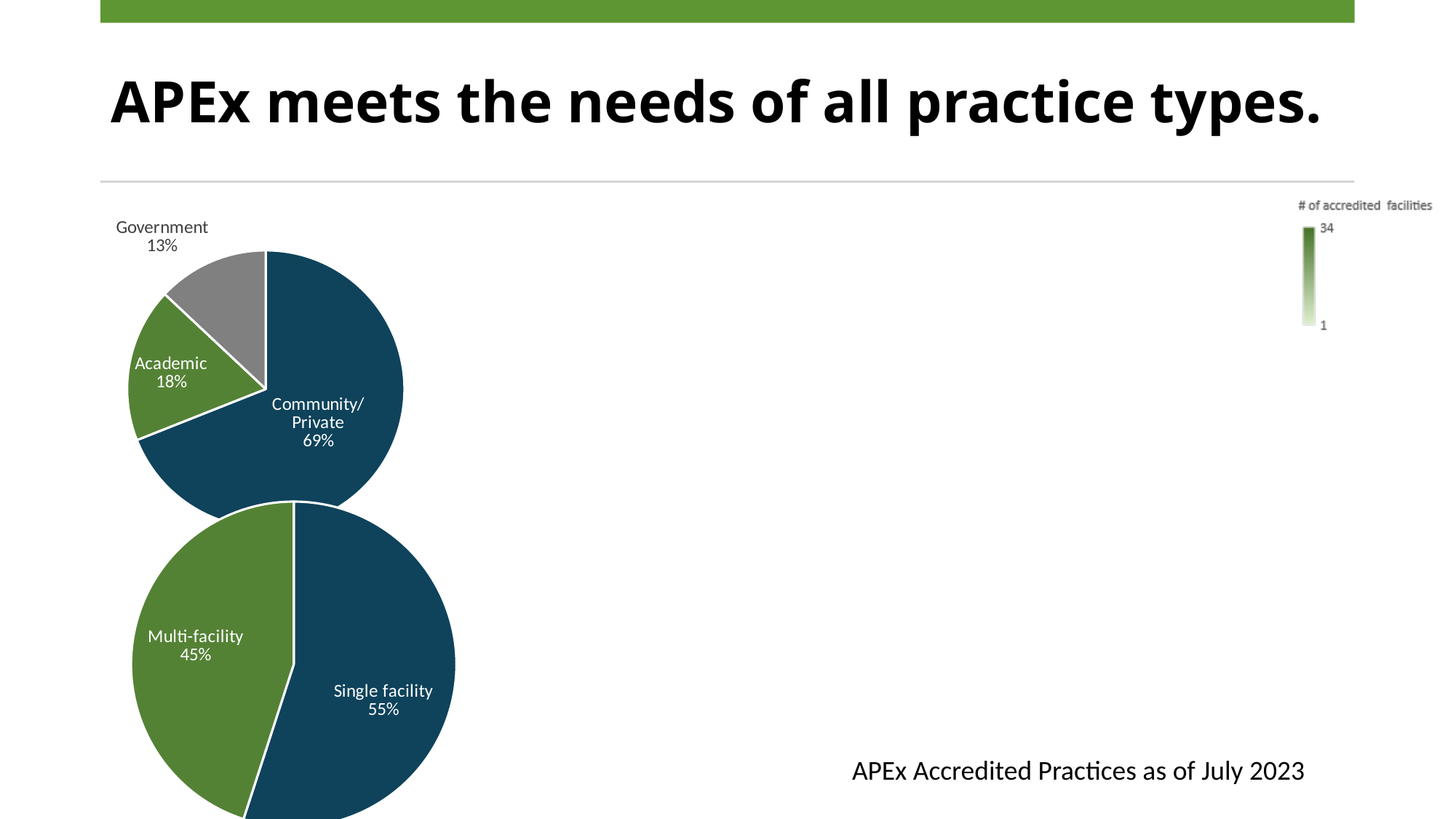
In the bottom pie chart, what share is labelled for Multi-facility? 45% In the top pie chart, what share is labelled for Government? 13% In the bottom pie chart, how many slices are there? 2 In the bottom pie chart, which is larger, Single facility or Multi-facility? Single facility In the top pie chart, what share is labelled for Community/Private? 69% In the top pie chart, which category has the largest slice? Community/Private In the top pie chart, which category has the smallest slice? Government In the top pie chart, what is the difference in percentage points between Academic and Government? 5 In the top pie chart, how many slices are there? 3 What kind of chart is the bottom chart on the slide? Pie chart